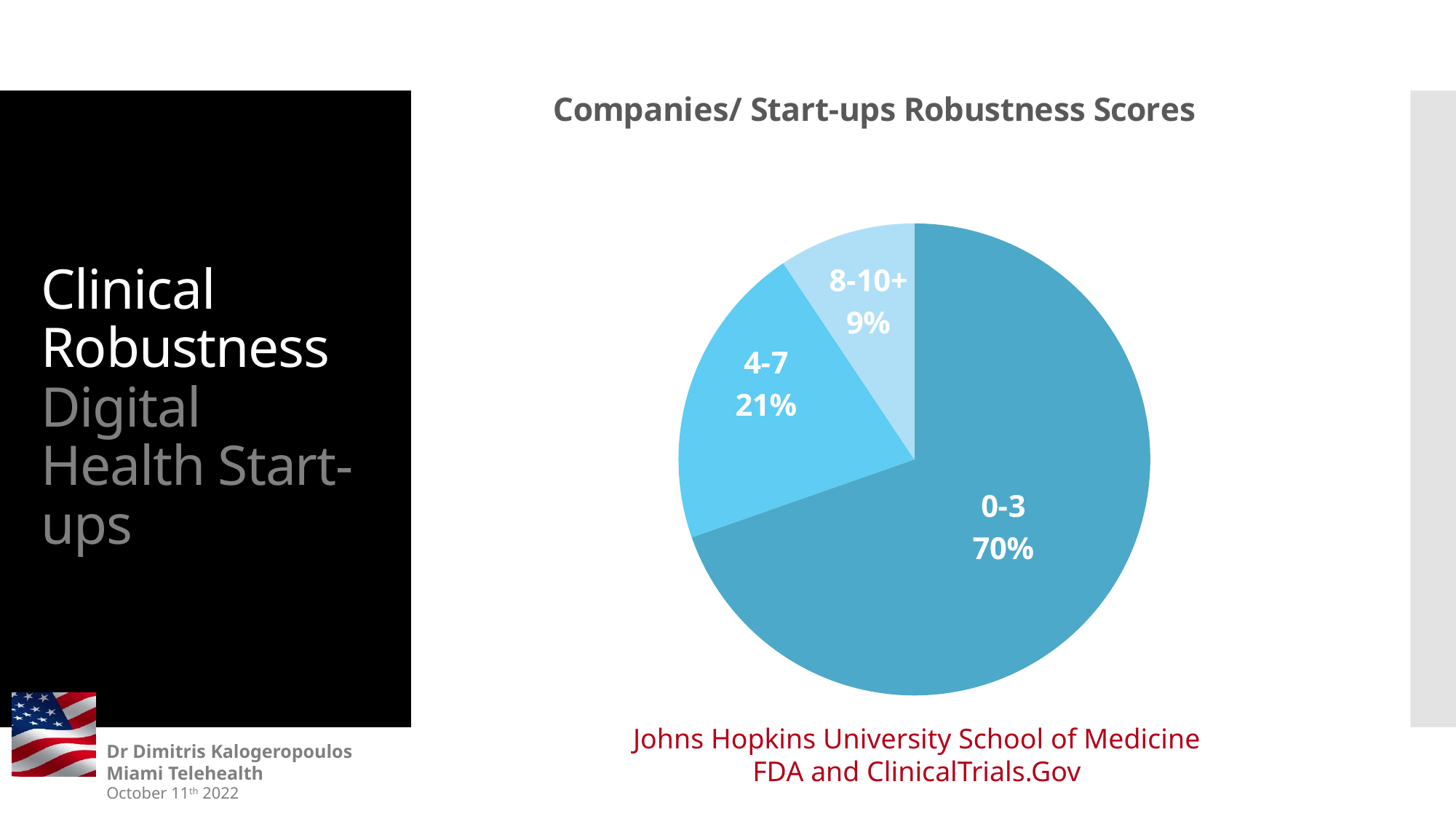
Which slice is the smallest? 8-10+ How many slices does the pie chart have? 3 What is the difference in percentage points between the 0-3 slice and the 4-7 slice? 49 Which slice is shown in the lightest shade of blue? 8-10+ What share of the pie does the 8-10+ slice represent? 9% What share of the pie does the 4-7 slice represent? 21% Which is larger, the 4-7 slice or the 8-10+ slice? 4-7 What is the title of the chart? Companies/ Start-ups Robustness Scores What share of the pie does the 0-3 slice represent? 70% What kind of chart is shown on the slide? pie chart What is the difference in percentage points between the 4-7 slice and the 8-10+ slice? 12 Which slice is the largest? 0-3